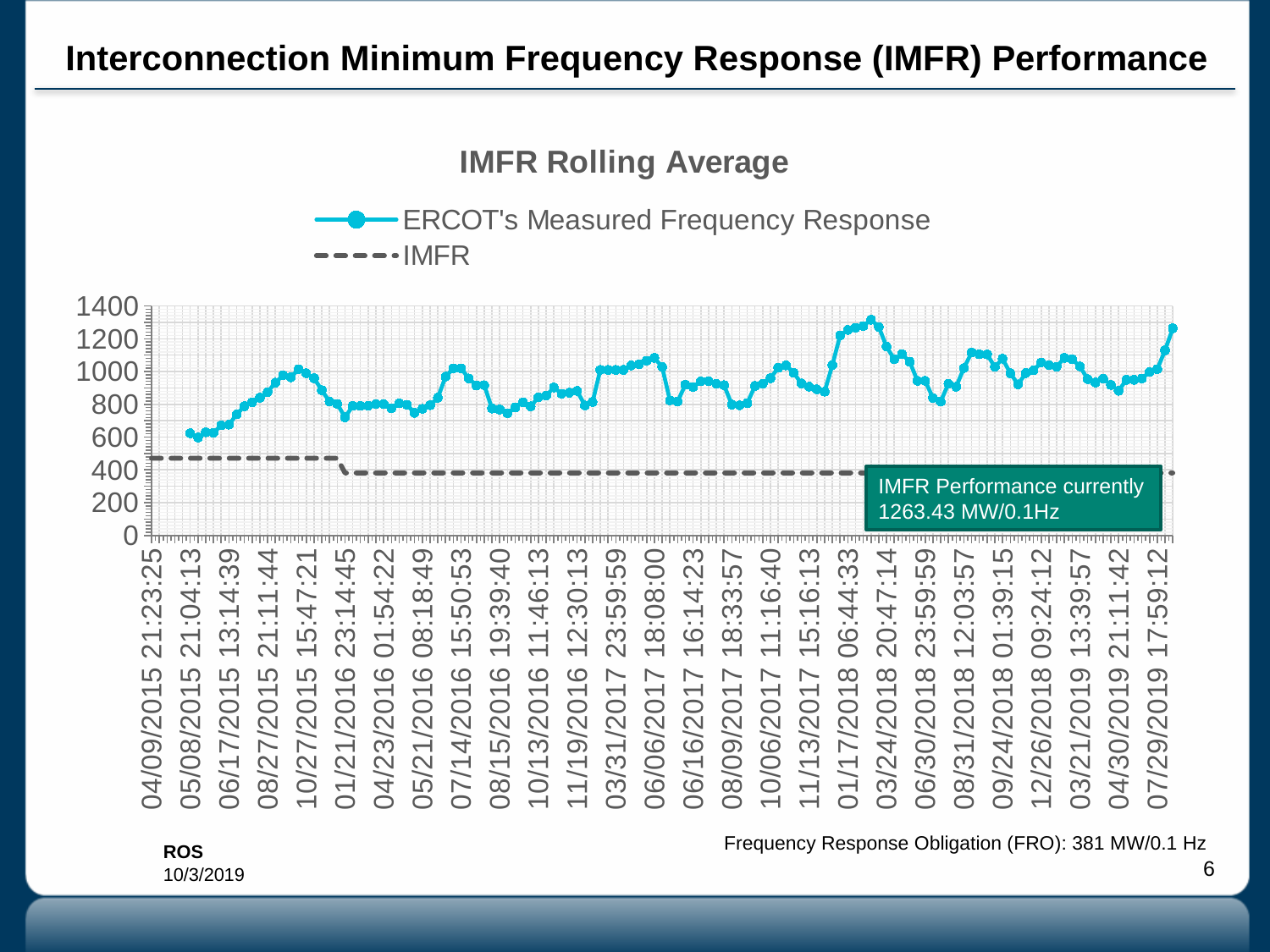
Is the IMFR value at 07/29/2019 17:59:12 greater or less than 600? less Which is larger at 01/17/2018 06:44:33: ERCOT's Measured Frequency Response or IMFR? ERCOT's Measured Frequency Response What is the title of the chart? IMFR Rolling Average Is ERCOT's Measured Frequency Response at 01/17/2018 06:44:33 greater or less than 1000? greater Does ERCOT's Measured Frequency Response rise or fall between 05/08/2015 21:04:13 and 10/27/2015 15:47:21? rise According to the callout on the chart, what is the current IMFR Performance? 1263.43 MW/0.1Hz Which series is drawn as a dashed line? IMFR Does the IMFR series rise or fall along the x axis between 10/27/2015 and 04/23/2016? fall Is ERCOT's Measured Frequency Response at 05/08/2015 21:04:13 greater or less than 800? less Which is larger for ERCOT's Measured Frequency Response: the value at 05/08/2015 21:04:13 or the value at 01/17/2018 06:44:33? 01/17/2018 06:44:33 How many series does the legend of the IMFR Rolling Average chart list? 2 What kind of chart is shown on the slide? line chart